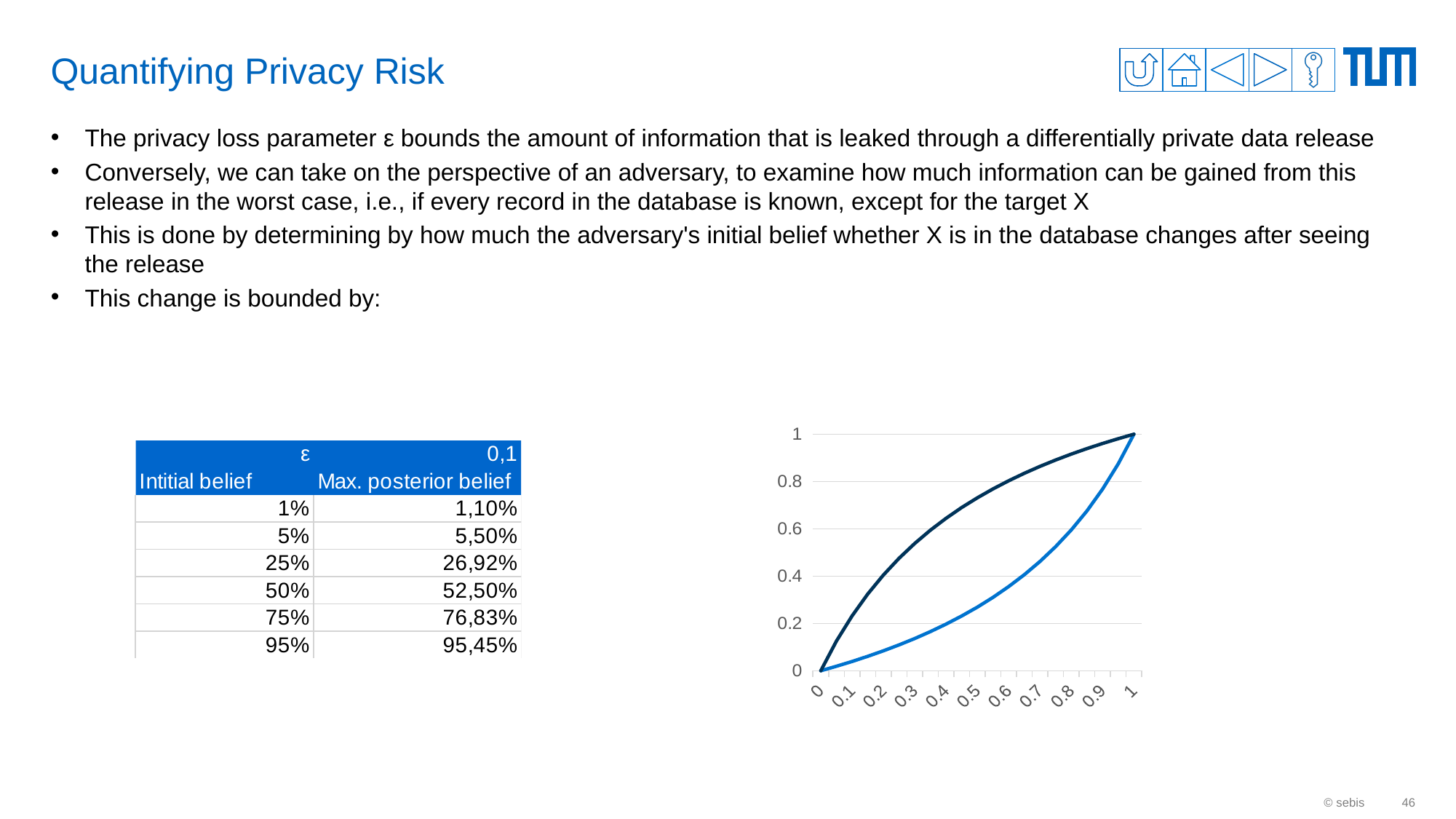
Is the value of the dark blue curve at x = 0.3 greater or less than 0.4? greater Is the value of the light blue curve at x = 0.3 greater or less than 0.2? less How many tick labels are shown on the x axis of the chart? 11 How many lines are plotted in the chart on the right? 2 What kind of chart is shown on the right of the slide? line chart At x = 0.5, which curve is higher, the dark blue one or the light blue one? the dark blue one Is the value of the light blue curve at x = 0.5 greater or less than 0.4? less Do the values of the curves rise or fall as x increases from 0 to 1? rise What is the highest tick label on the y axis of the chart? 1 What value do both curves reach at x = 1? 1 What value do both curves have at x = 0? 0